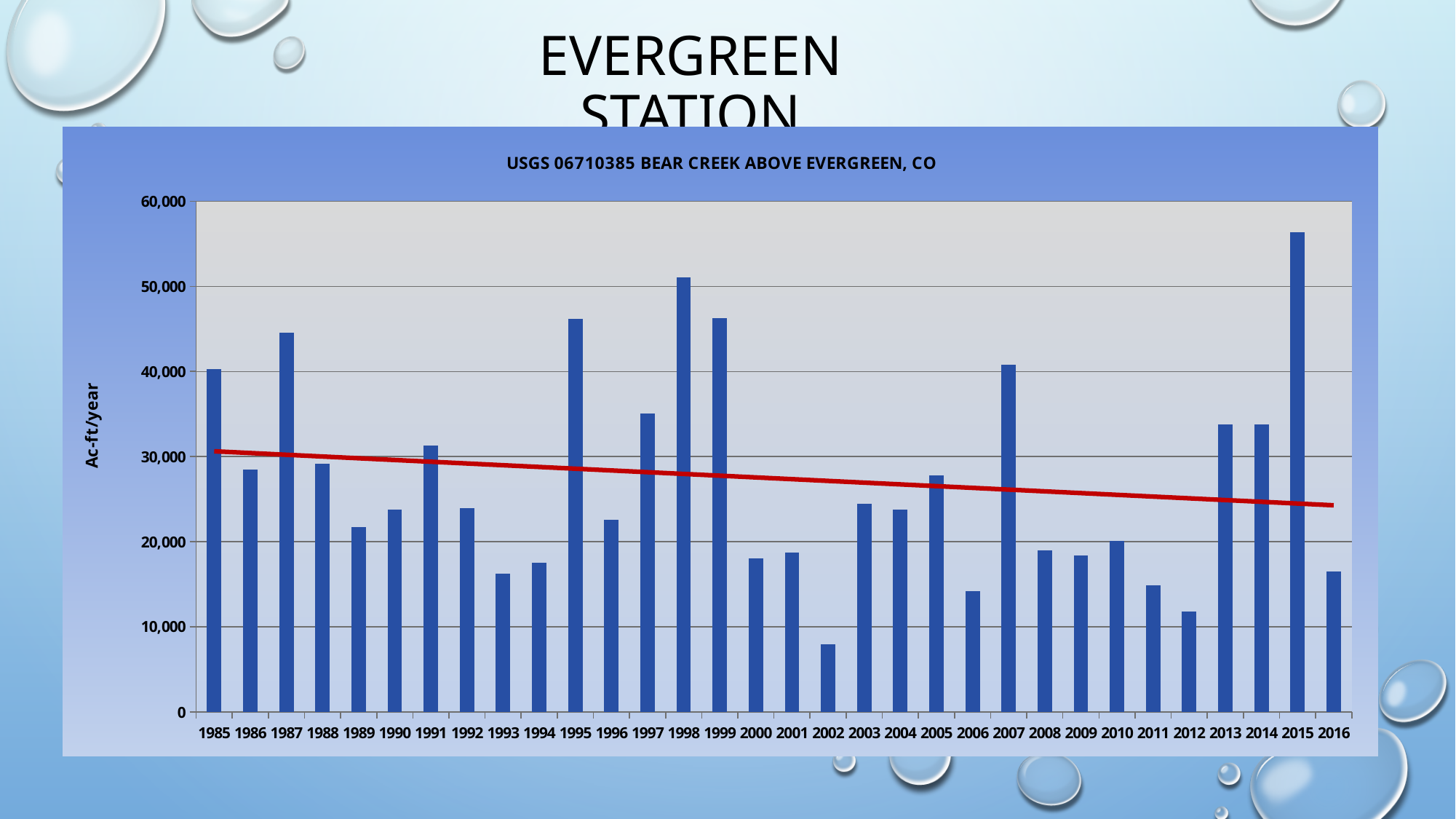
Is the value for 2015 greater or less than 50,000? greater How many years are plotted on the x axis? 32 What kind of chart is shown on the slide? bar chart Which year has the lowest bar? 2002 Does the red trend line rise or fall from 1985 to 2016? fall Which year has the highest bar? 2015 Is the value for 1993 greater or less than 20,000? less Is the value for 2002 greater or less than 10,000? less What is the label on the vertical axis? Ac-ft/year What is the title of the chart? USGS 06710385 BEAR CREEK ABOVE EVERGREEN, CO Which year has the larger value, 1986 or 1987? 1987